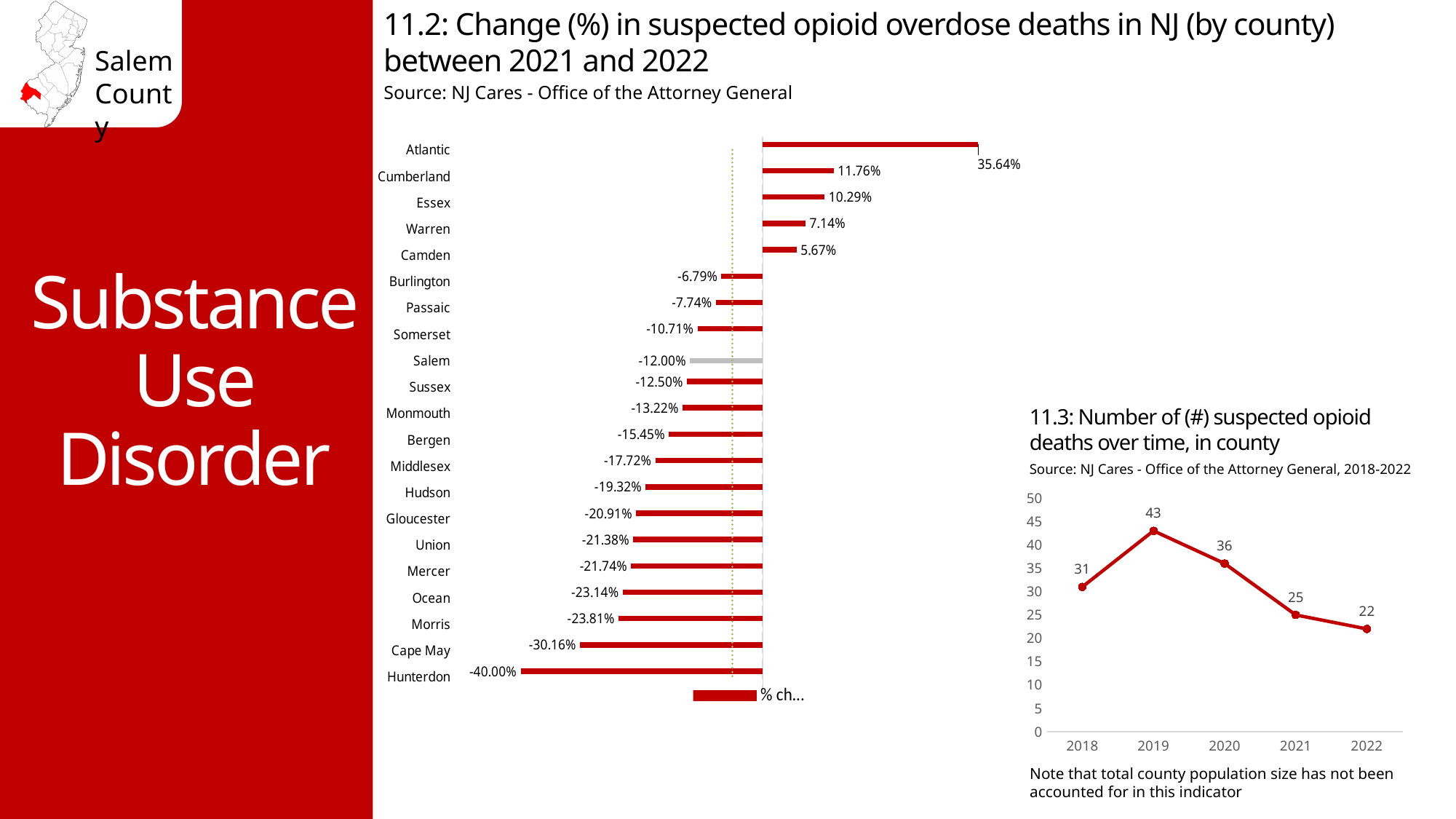
In chart 11.2, how many counties are shown? 21 In chart 11.2, which county has a larger percent change, Essex or Warren? Essex In chart 11.3, do the values rise or fall from 2019 to 2022? Fall In chart 11.2, which county has the highest percent change? Atlantic What kind of chart is chart 11.2? Bar chart In chart 11.2, what is the percent change for Cumberland? 11.76% In chart 11.3, how many suspected opioid deaths were there in 2019? 43 In chart 11.2, what is the difference between the percent change for Atlantic and Cumberland? 23.88% In chart 11.3, which year had the lowest number of suspected opioid deaths? 2022 In chart 11.2, what is the percent change in suspected opioid overdose deaths for Salem county? -12.00% In chart 11.3, what is the difference in suspected opioid deaths between 2019 and 2022? 21 In chart 11.2, which county has the lowest percent change? Hunterdon